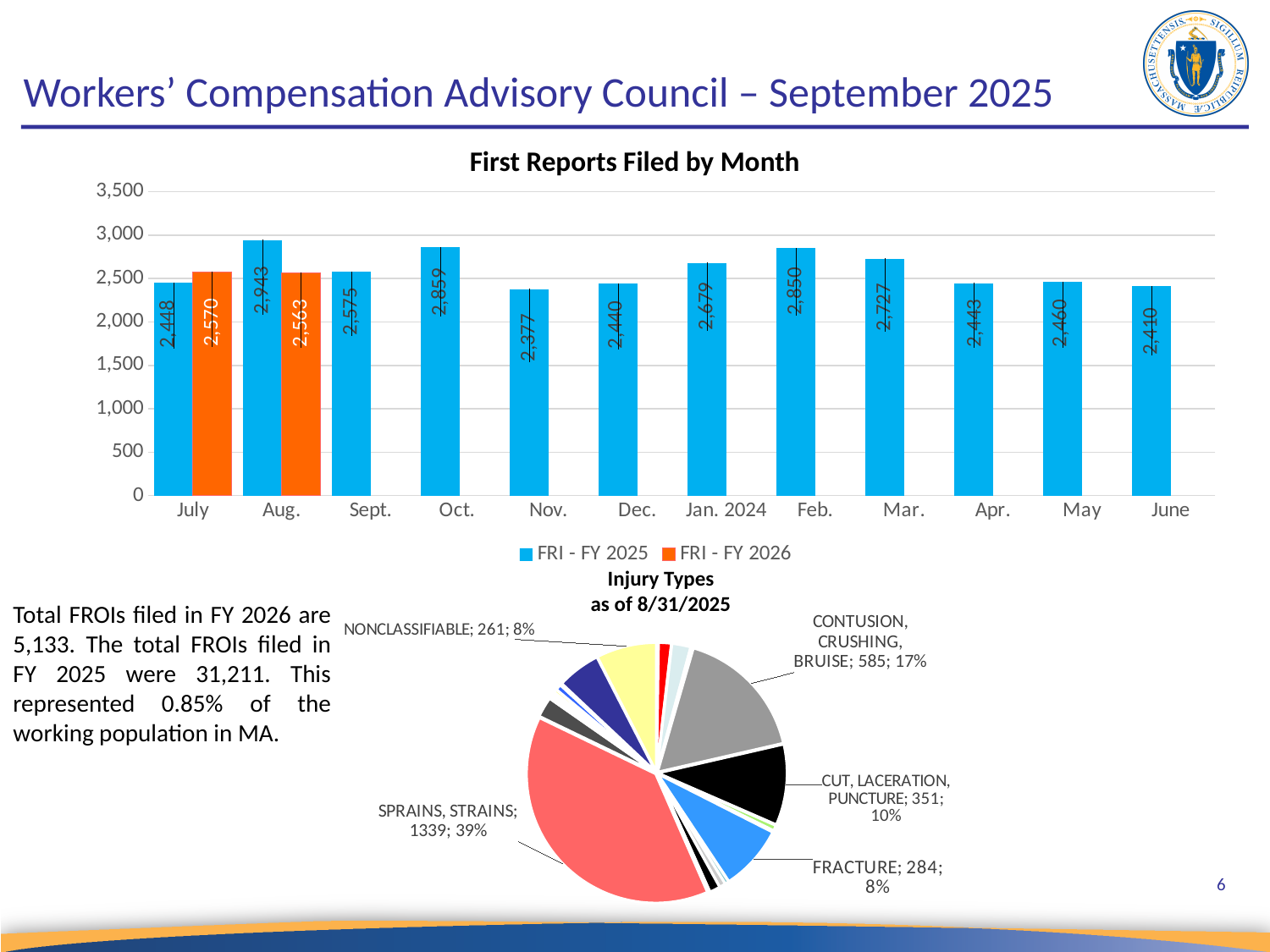
What kind of chart is 'First Reports Filed by Month'? bar chart In the 'First Reports Filed by Month' chart, which month has the highest FRI - FY 2025 value? Aug. In the 'Injury Types as of 8/31/2025' chart, what share of the pie is CONTUSION, CRUSHING, BRUISE? 17% In the 'First Reports Filed by Month' chart, which month has the lowest FRI - FY 2025 value? Nov. In the 'First Reports Filed by Month' chart, which series has the larger value for Aug., FRI - FY 2025 or FRI - FY 2026? FRI - FY 2025 In the 'First Reports Filed by Month' chart, is the FRI - FY 2025 value for Oct. greater or less than 2,500? greater In the 'First Reports Filed by Month' chart, what is the FRI - FY 2026 value for July? 2,570 In the 'First Reports Filed by Month' chart, how much higher is the FRI - FY 2026 value for July than the FRI - FY 2025 value for July? 122 How many series does the legend of the 'First Reports Filed by Month' chart list? 2 In the 'First Reports Filed by Month' chart, what is the FRI - FY 2025 value for Aug.? 2,943 In the 'Injury Types as of 8/31/2025' chart, how many injuries are SPRAINS, STRAINS? 1339 How many months are shown on the x axis of the 'First Reports Filed by Month' chart? 12